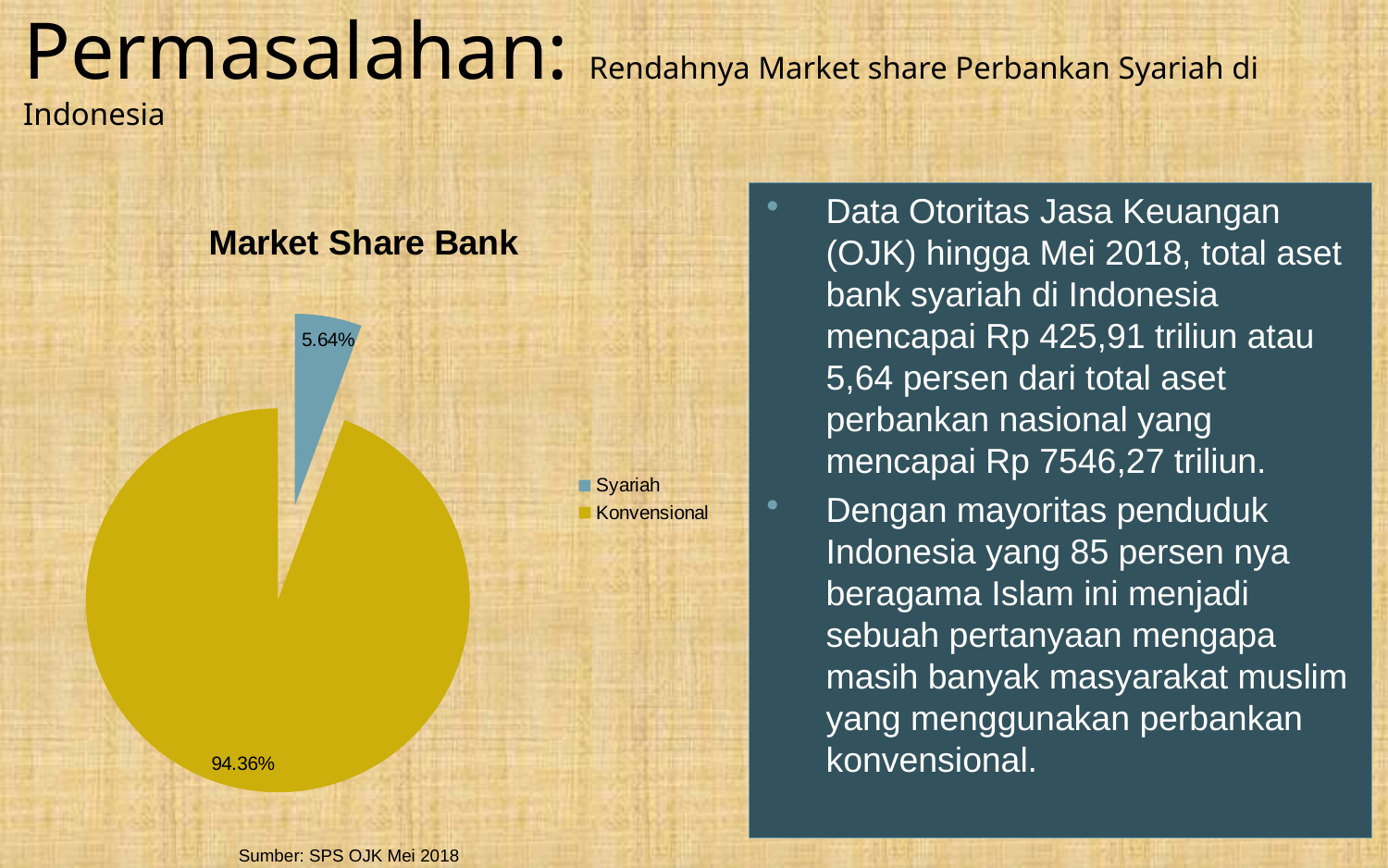
Which colour represents Syariah in the pie chart? blue What type of chart is shown on the slide? pie chart What is the market share of Konvensional banks shown in the pie chart? 94.36% What share of the pie does the Syariah slice represent? 5.64% Which is larger, the Syariah slice or the Konvensional slice? Konvensional What is the difference in percentage points between the Konvensional and Syariah slices? 88.72 What is the market share of Syariah banks shown in the pie chart? 5.64% How many entries does the legend list? 2 How many categories does the pie chart show? 2 What is the title of the chart? Market Share Bank Which category has the smallest slice of the pie? Syariah Which category has the largest slice of the pie? Konvensional